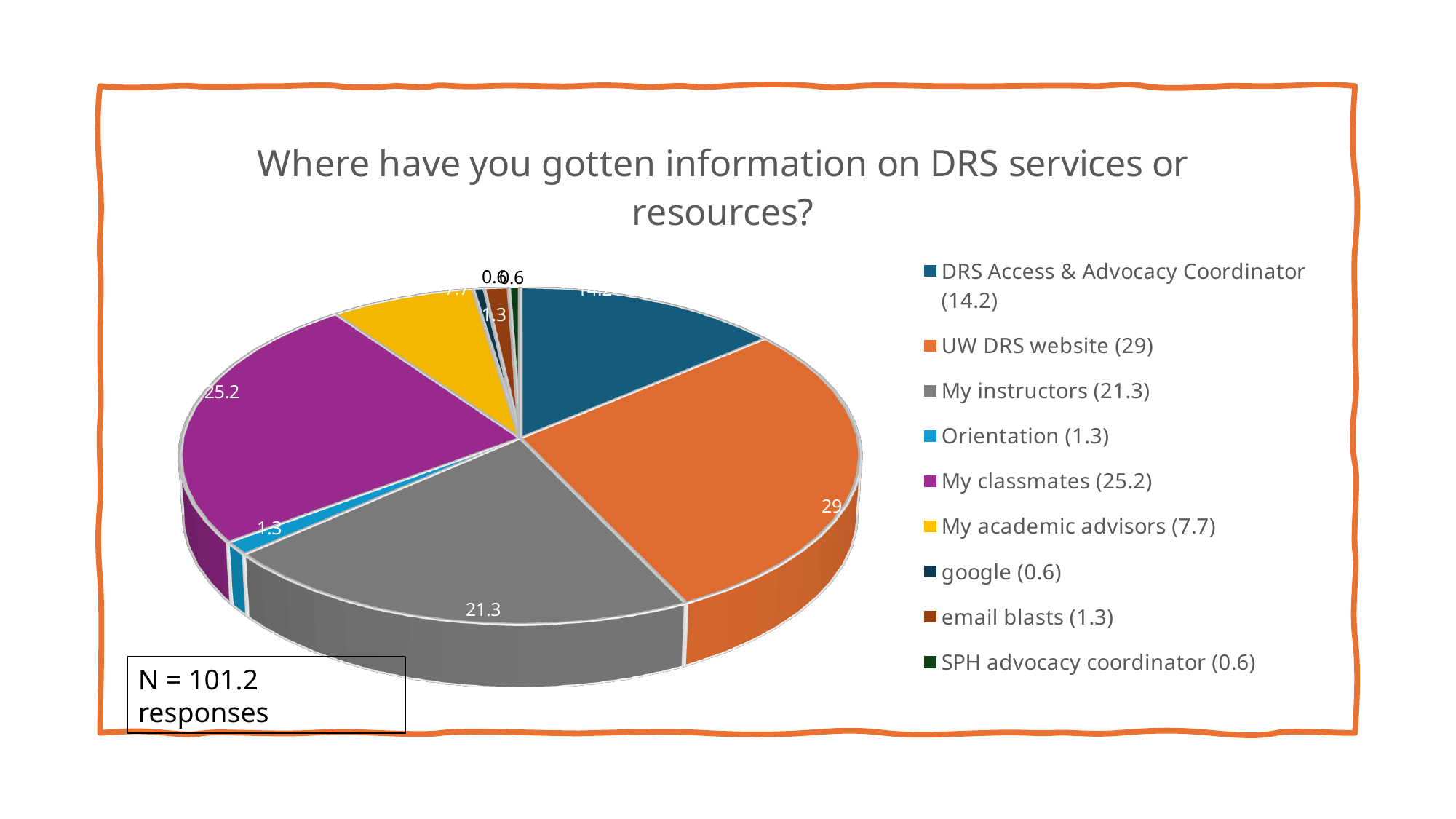
What type of chart is shown on the slide? pie chart What colour is the slice for My classmates? purple How many categories does the legend list? 9 What is the value for DRS Access & Advocacy Coordinator? 14.2 Which category has the larger value, My instructors or My classmates? My classmates What is the value for UW DRS website? 29 Which category has the largest slice of the pie? UW DRS website What is the value for My academic advisors? 7.7 What is the value for My classmates? 25.2 What is the title of the chart? Where have you gotten information on DRS services or resources? What is the difference between the values for UW DRS website and My instructors? 7.7 What is the difference between the values for My classmates and DRS Access & Advocacy Coordinator? 11